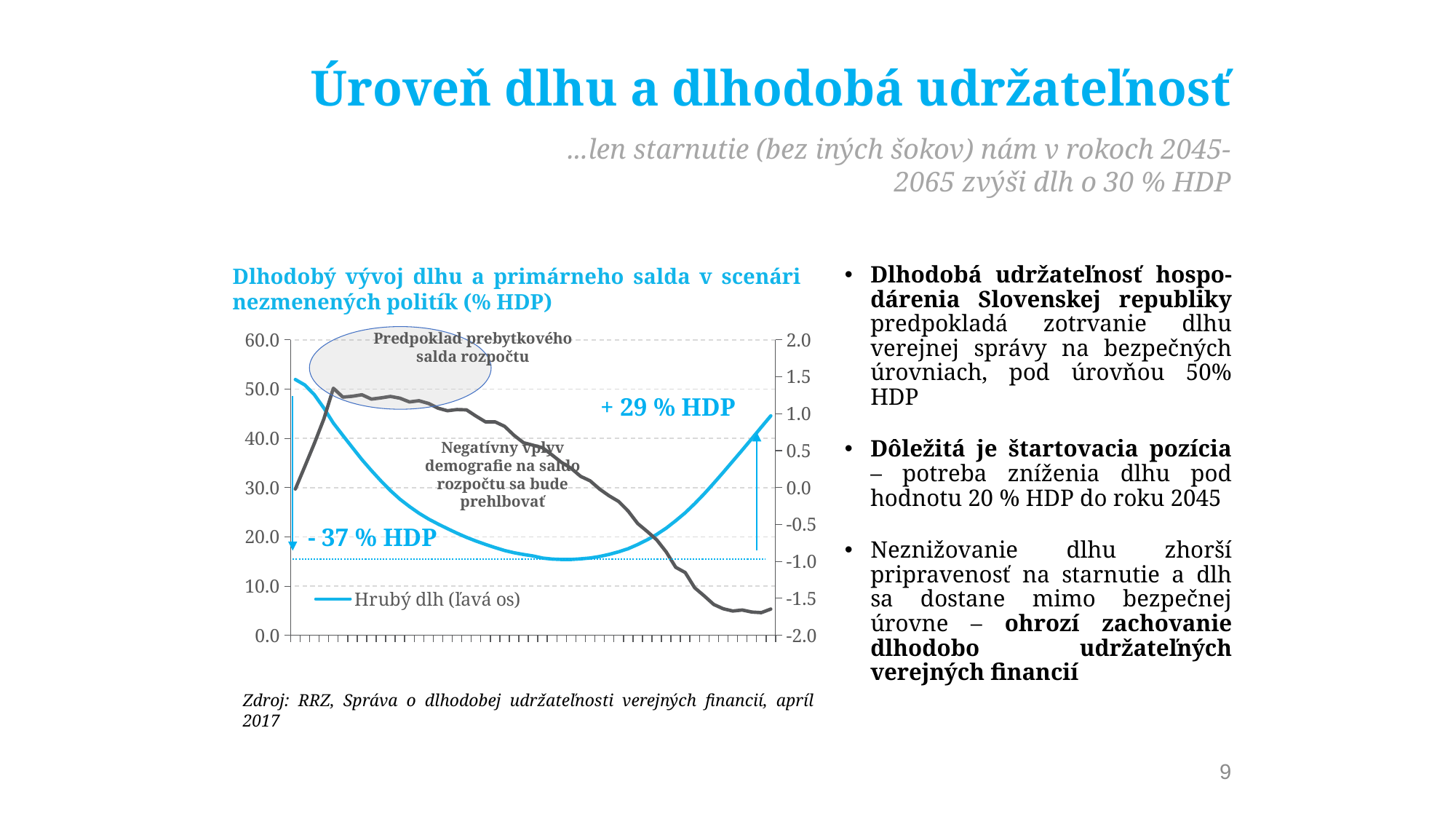
Does the grey primary balance line rise or fall over the second half of the chart? fall What decrease in debt is annotated on the chart next to the downward arrow? - 37 % HDP What is the lowest tick value shown on the right axis of the chart? -2.0 What increase in debt is annotated on the chart next to the upward arrow? + 29 % HDP What is the title of the chart? Dlhodobý vývoj dlhu a primárneho salda v scenári nezmenených politík (% HDP) Is the lowest point of the Hrubý dlh line greater or less than 20.0 on the left axis? less What is the highest tick value shown on the left axis of the chart? 60.0 Is the starting value of the Hrubý dlh line greater or less than 50.0 on the left axis? greater Is the final value of the Hrubý dlh line greater or less than 40.0 on the left axis? greater Which series is named in the chart legend? Hrubý dlh (ľavá os) What kind of chart is shown on the slide? line chart